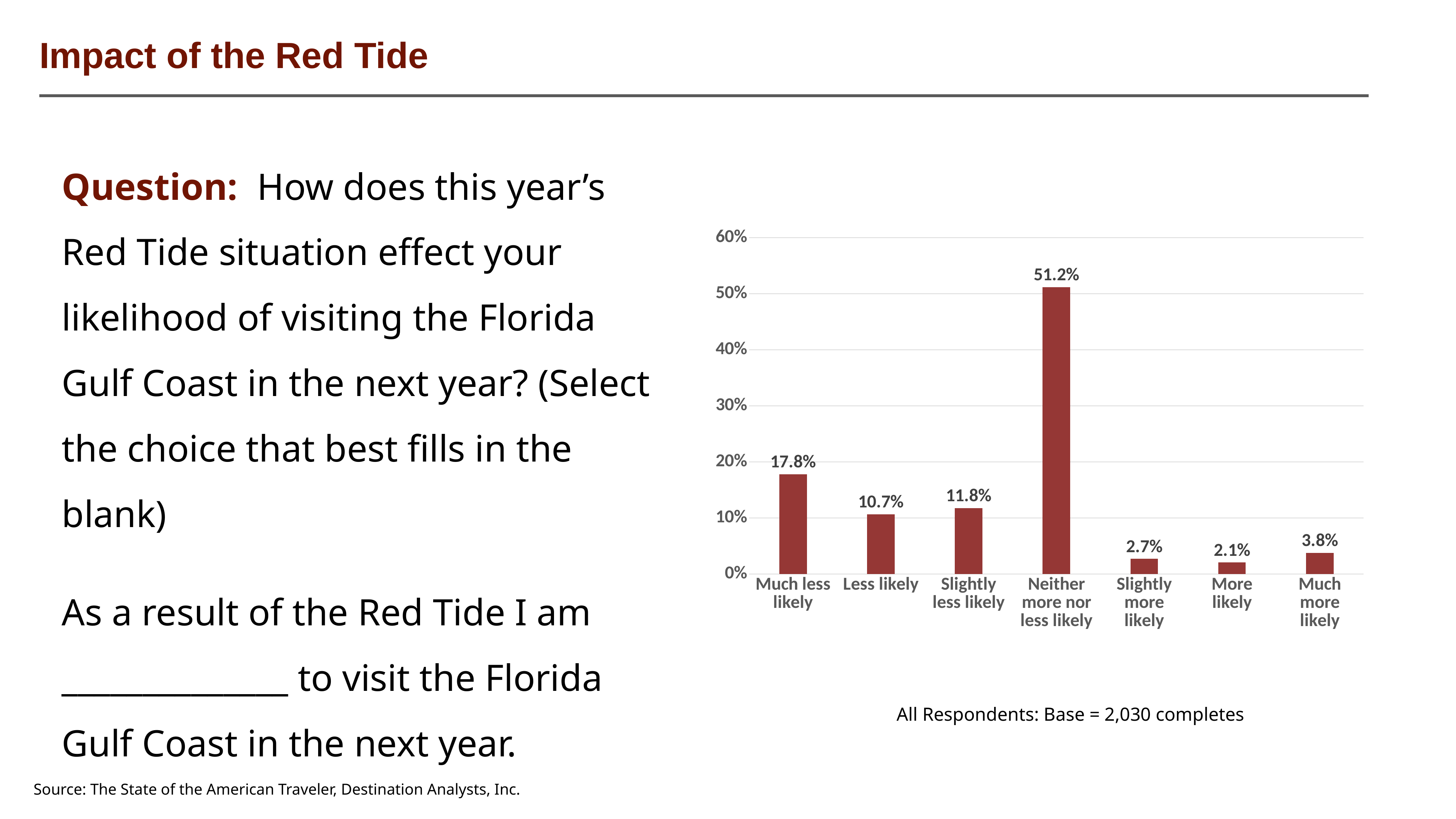
Which category has the lowest value? More likely What is the value for the 'Neither more nor less likely' category? 51.2% How many categories are shown on the x axis of the chart? 7 What kind of chart is shown on the slide? Bar chart What percentage of respondents said they are slightly less likely to visit? 11.8% What is the difference between the 'Much less likely' and 'Less likely' values? 7.1% What percentage of respondents said they are much less likely to visit the Florida Gulf Coast? 17.8% Which category has the highest value? Neither more nor less likely Which is larger, the value for 'Slightly less likely' or the value for 'Less likely'? Slightly less likely Is the value for 'Neither more nor less likely' greater or less than 50%? greater What is the base number of completes stated below the chart? 2,030 completes What is the value for 'Much more likely'? 3.8%